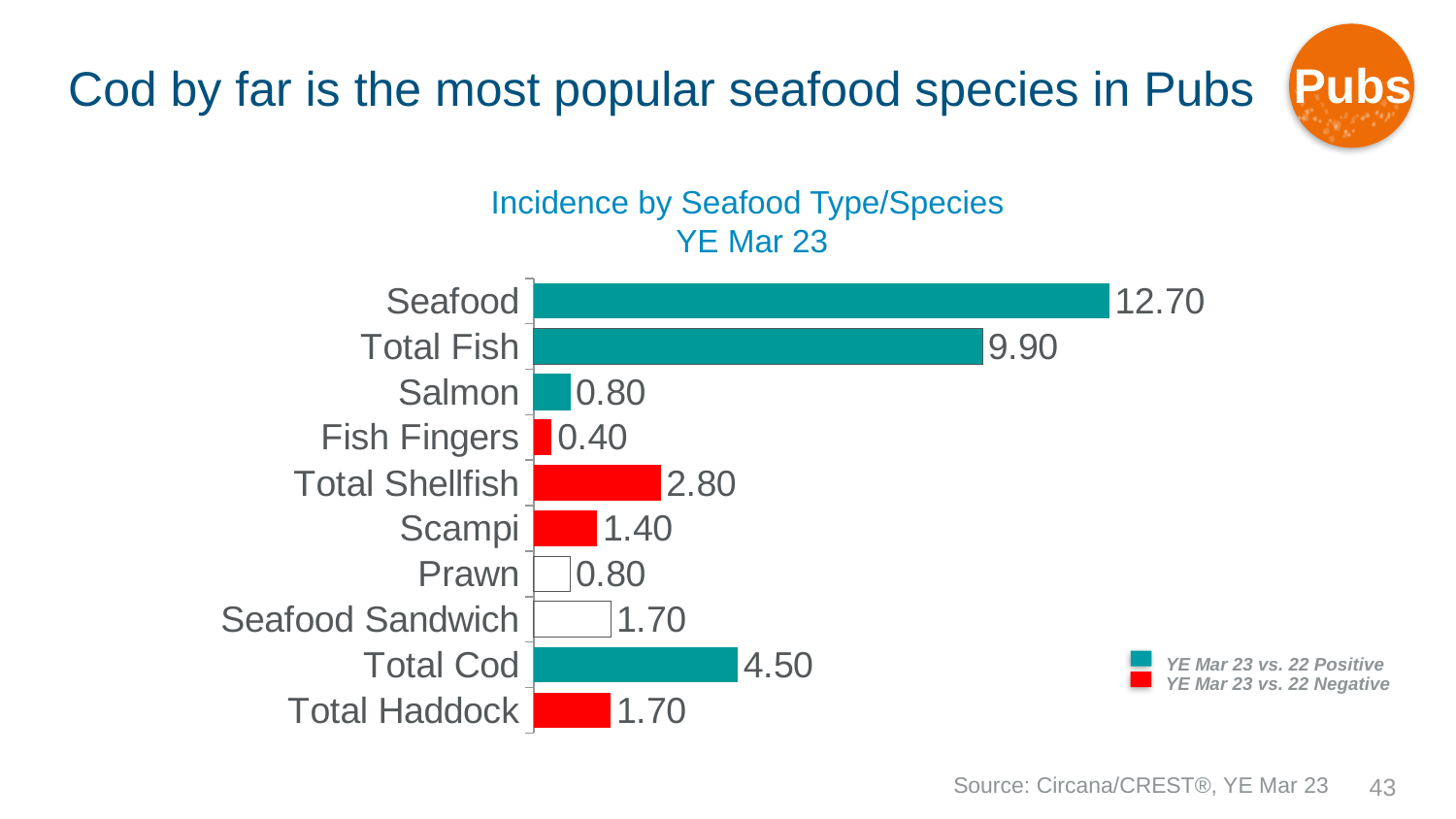
How many categories are shown in the chart? 10 Which category has the lowest value? Fish Fingers What is the value for Seafood? 12.70 What is the difference between the values for Seafood and Total Fish? 2.80 Which is larger, the value for Total Shellfish or the value for Seafood Sandwich? Total Shellfish What is the value for Total Cod? 4.50 According to the legend, what does a red bar indicate? YE Mar 23 vs. 22 Negative Which category has the highest value? Seafood What is the difference between the values for Total Cod and Total Haddock? 2.80 What kind of chart is shown on the slide? Bar chart What is the value for Total Shellfish? 2.80 What is the value for Scampi? 1.40